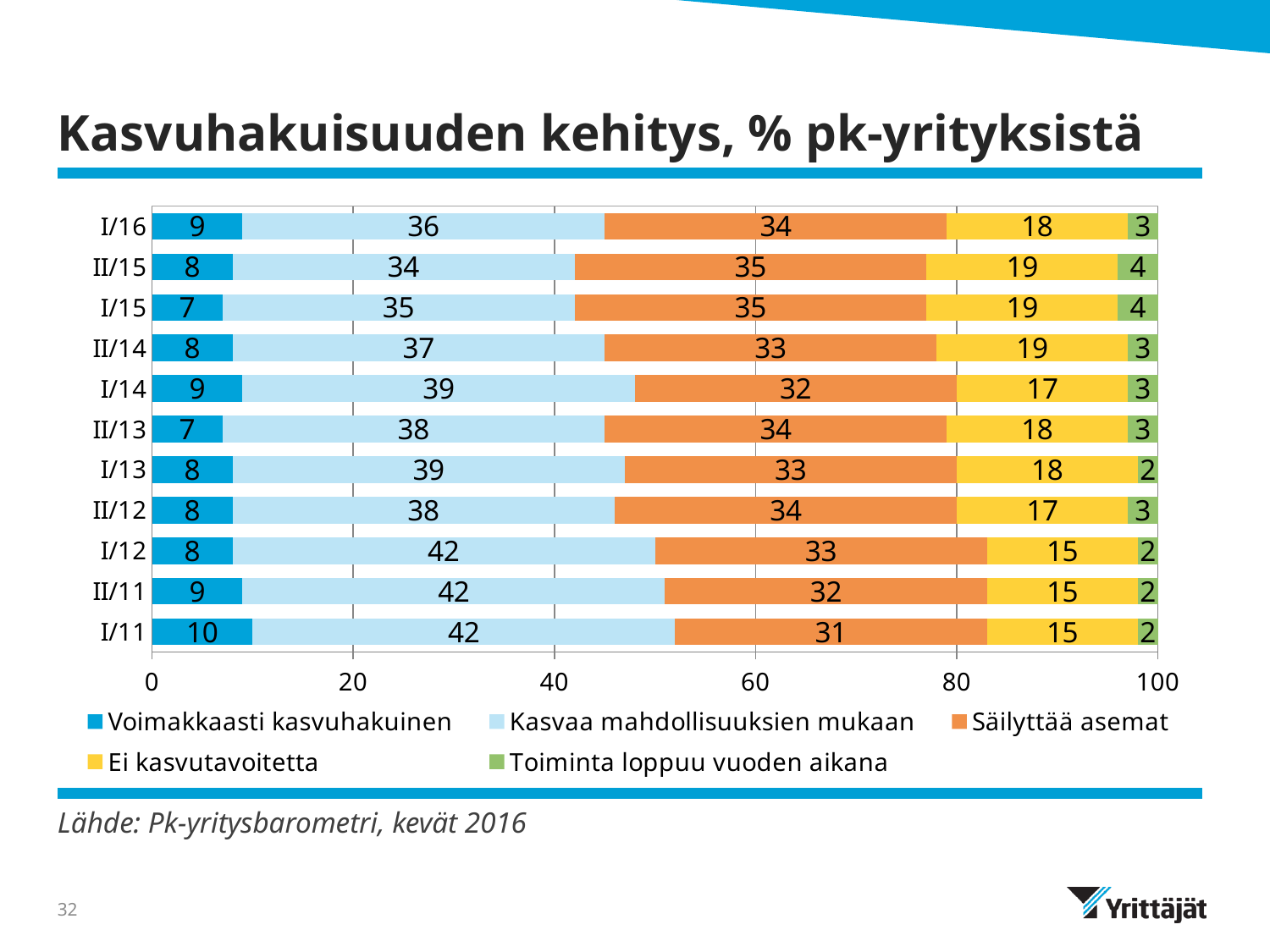
What is the value for "Kasvaa mahdollisuuksien mukaan" in I/16? 36 What kind of chart is shown on the slide? Stacked bar chart Which period has the highest value for "Voimakkaasti kasvuhakuinen"? I/11 What is the value for "Säilyttää asemat" in II/15? 35 What is the value for "Ei kasvutavoitetta" in I/12? 15 What is the total of the stacked bar for I/15? 100 How many periods are shown on the chart? 11 What is the value for "Voimakkaasti kasvuhakuinen" in I/11? 10 What is the difference between the "Kasvaa mahdollisuuksien mukaan" values for I/11 and I/16? 6 Which period has the lowest value for "Säilyttää asemat"? I/11 How many series does the legend list? 5 Which is larger: "Ei kasvutavoitetta" in I/16 or in I/11? I/16